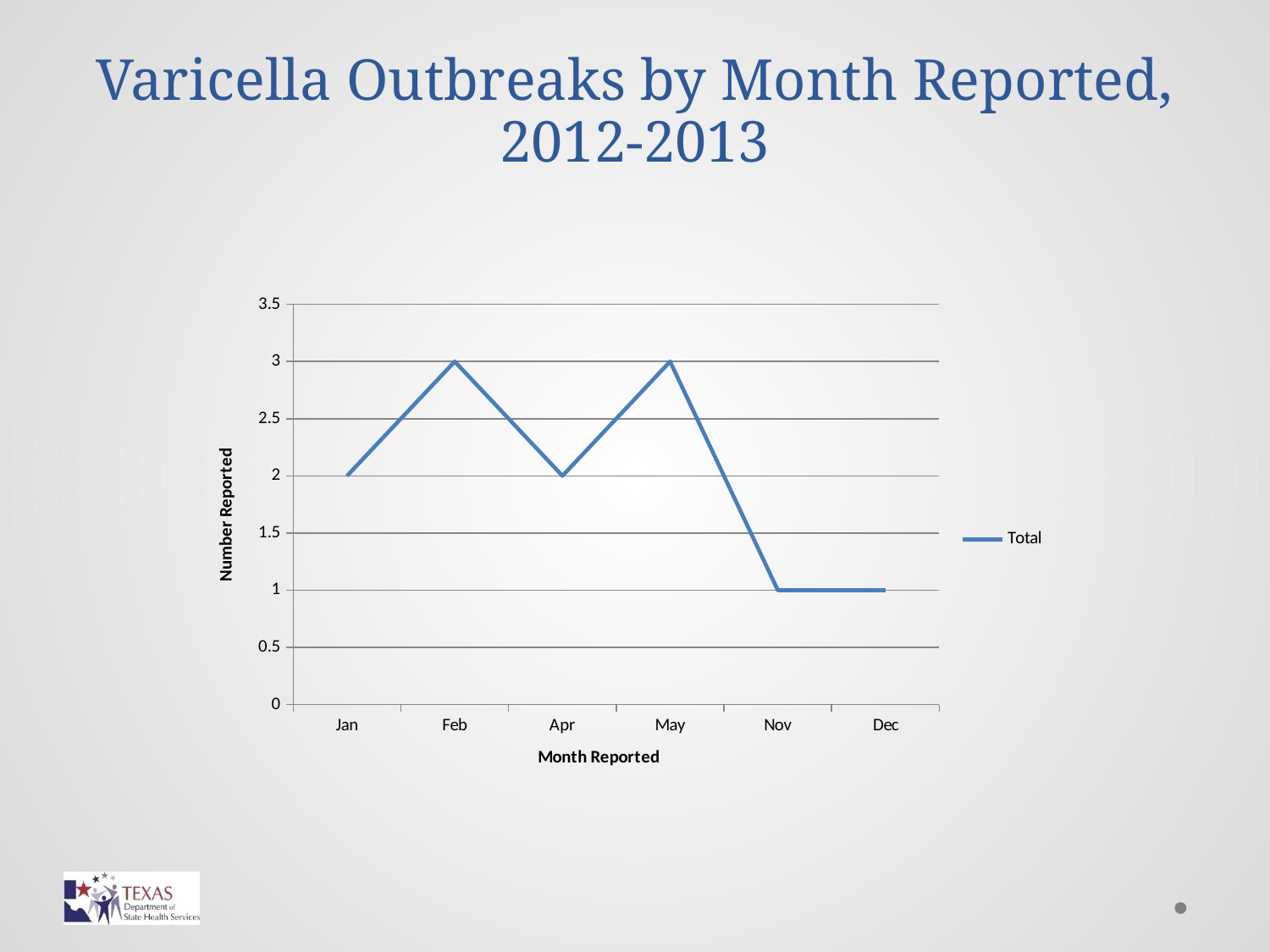
Is the value for Dec greater or less than 2? less What is the difference between the number reported in Feb and the number reported in Jan? 1 Which month has the larger number reported, Feb or Apr? Feb How many series does the legend list? 1 What is the label of the y axis? Number Reported What is the number reported for Jan? 2 What is the number reported for May? 3 How many months are shown on the x axis? 6 What is the number reported for Feb? 3 Does the number reported rise or fall from May to Nov? fall What is the number reported for Nov? 1 What type of chart is shown on the slide? line chart